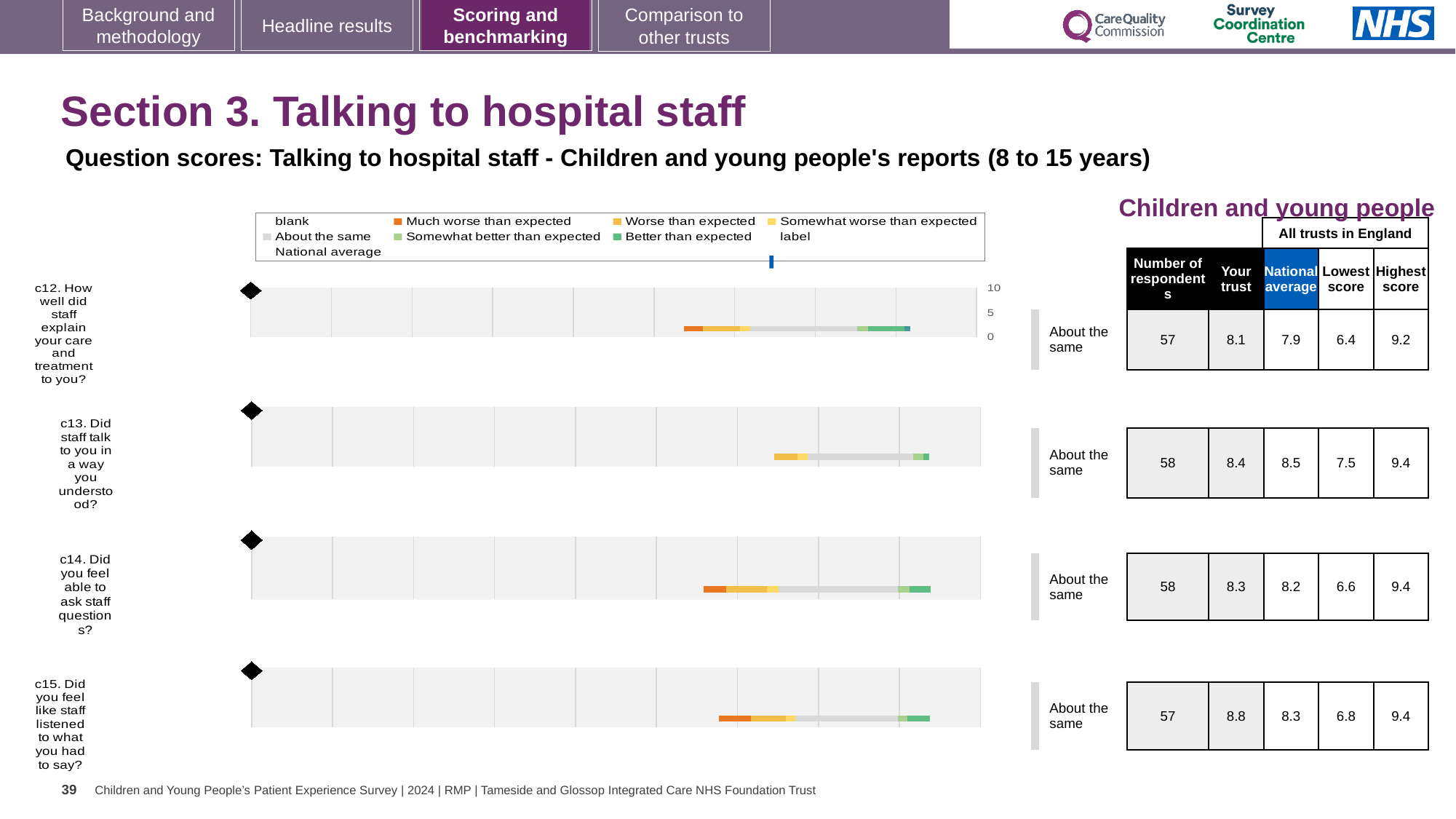
For c15, what is the difference between the 'Your trust' score and the national average? 0.5 What kind of chart is used to show the question scores for c12 to c15? bar chart Is the 'Your trust' score for c12 greater or less than 5? greater What is the 'Your trust' score for c12 (How well did staff explain your care and treatment to you?)? 8.1 What benchmark category is shown next to the chart for c14 (Did you feel able to ask staff questions?)? About the same How many respondents answered c14 (Did you feel able to ask staff questions?)? 58 What is the national average score for c13 (Did staff talk to you in a way you understood?)? 8.5 How many questions (c12 to c15) are plotted on the slide? 4 Which question has the highest 'Your trust' score? c15. Did you feel like staff listened to what you had to say? Which question has the lowest 'Your trust' score? c12. How well did staff explain your care and treatment to you? For c13, which is larger: the 'Your trust' score or the national average? National average What is the highest score among all trusts in England for c15 (Did you feel like staff listened to what you had to say?)? 9.4